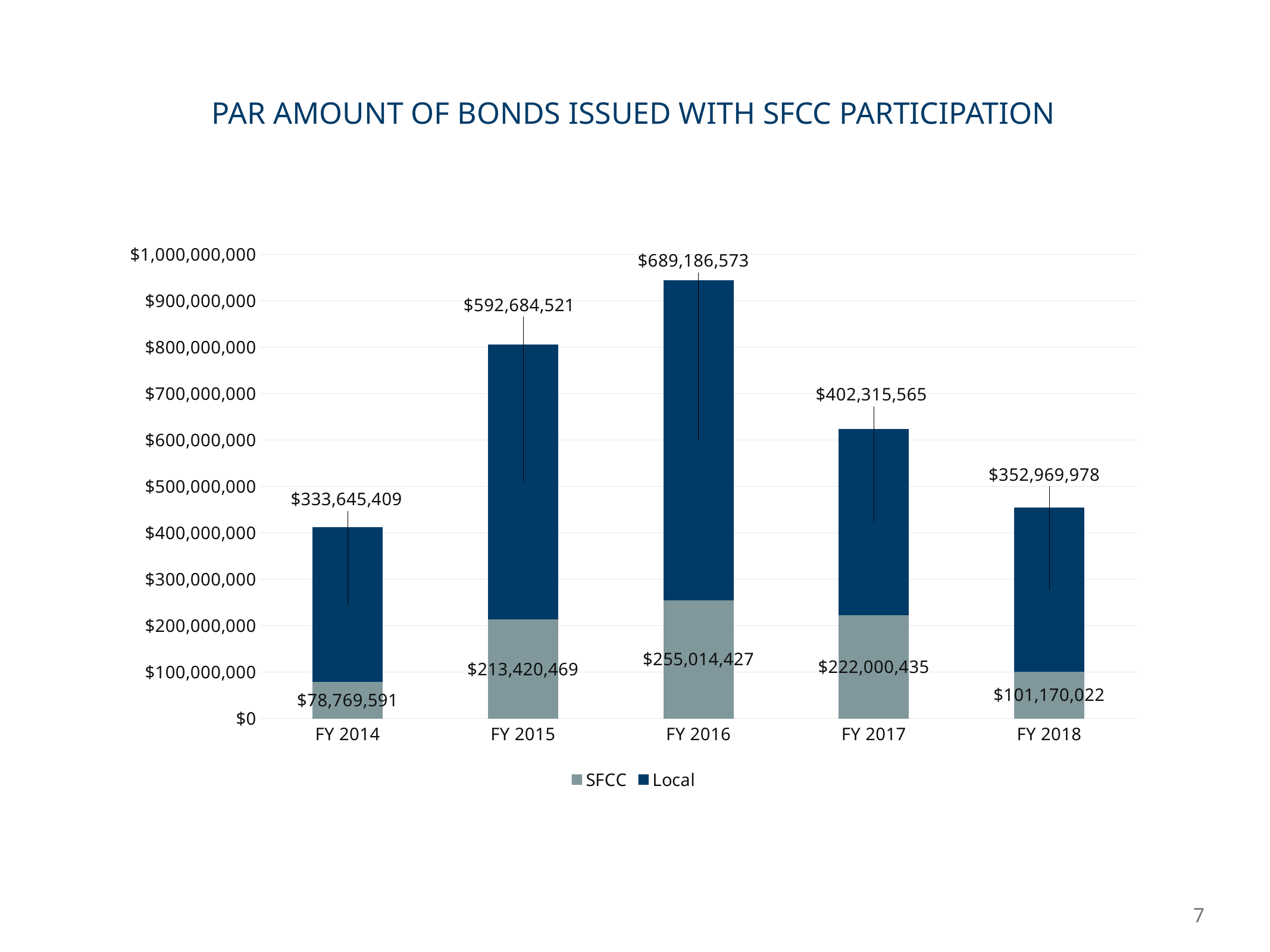
Which fiscal year has the highest Local value? FY 2016 What kind of chart is shown on the slide? Stacked bar chart How many series does the legend list? 2 Is the total stacked bar for FY 2015 greater or less than $700,000,000? greater What is the difference between the Local values for FY 2016 and FY 2015? $96,502,052 Which fiscal year has the lowest SFCC value? FY 2014 What is the Local value for FY 2016? $689,186,573 Which is larger, the SFCC value for FY 2017 or the SFCC value for FY 2015? FY 2017 How many fiscal years are shown on the x axis? 5 What is the SFCC value for FY 2015? $213,420,469 What is the total of the stacked bar for FY 2014? $412,415,000 What is the SFCC value for FY 2018? $101,170,022